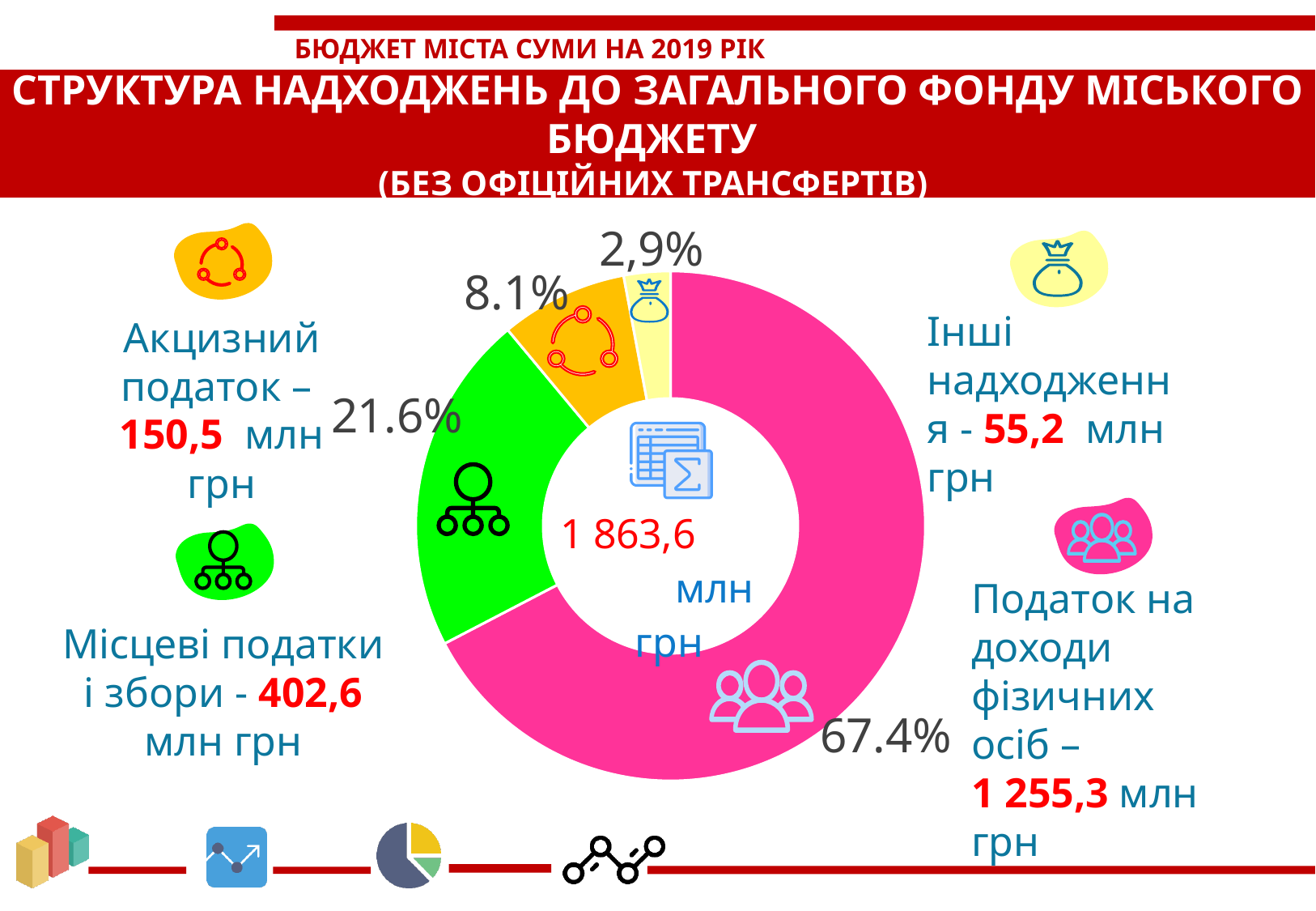
What is the total shown in the centre of the donut chart? 1 863,6 млн грн By how many percentage points does the share of 'Податок на доходи фізичних осіб' exceed that of 'Місцеві податки і збори'? 45.8 What share of the chart does 'Акцизний податок' represent? 8.1% Which category has the largest slice of the chart? Податок на доходи фізичних осіб What share of the chart does 'Місцеві податки і збори' represent? 21.6% What is the value for 'Акцизний податок' in млн грн? 150,5 Which category has the smallest slice of the chart? Інші надходження What is the value for 'Місцеві податки і збори' in млн грн? 402,6 How many slices does the donut chart have? 4 What share of the chart does 'Податок на доходи фізичних осіб' represent? 67.4% What kind of chart is shown on the slide? Pie (donut) chart